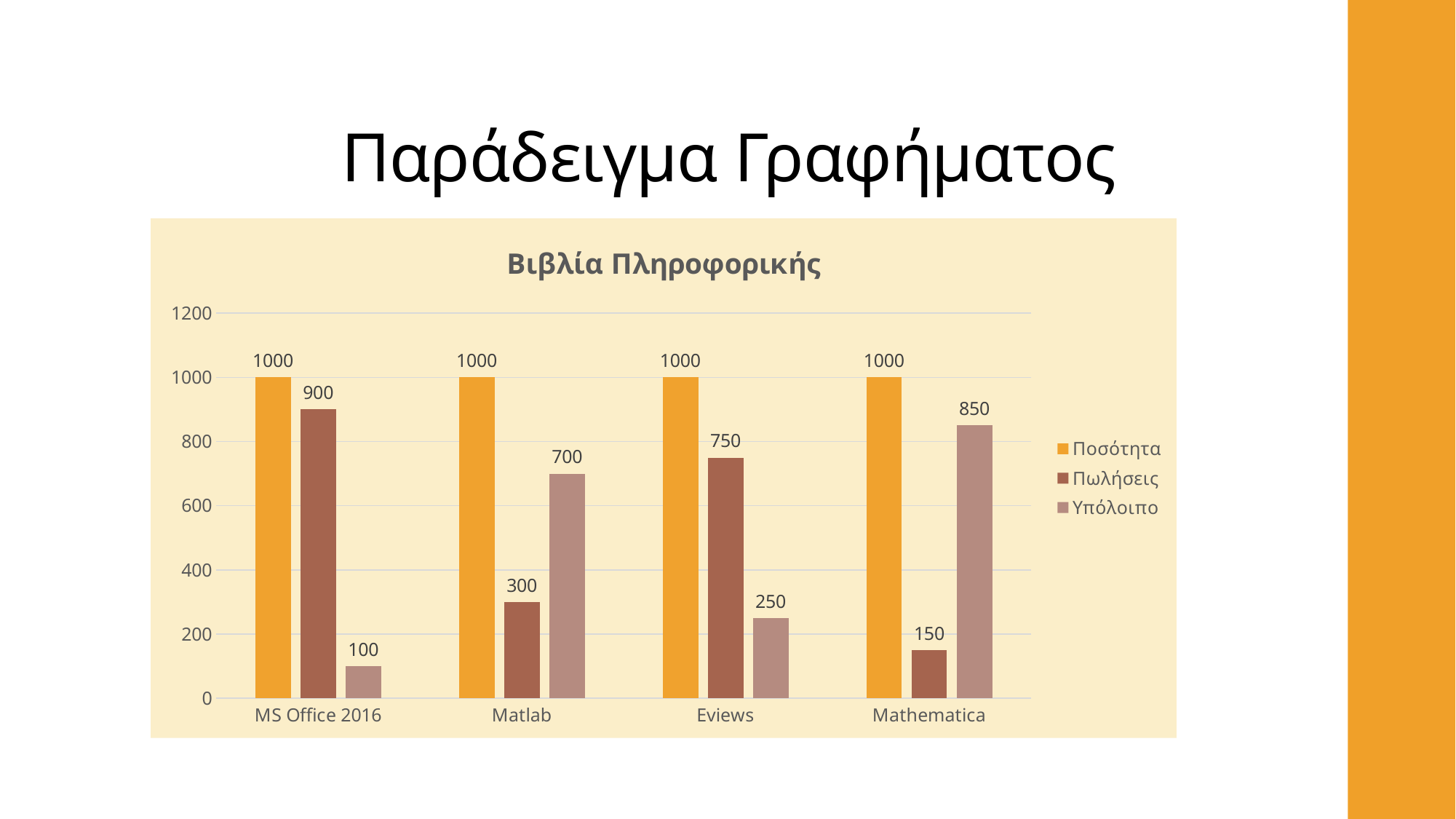
What is the Πωλήσεις value for MS Office 2016? 900 What is the difference between the Υπόλοιπο values for Mathematica and Eviews? 600 How many series does the legend list? 3 What is the Ποσότητα value for Mathematica? 1000 How many categories are shown on the x axis? 4 What kind of chart is shown? Bar chart Which is larger: the Πωλήσεις value for Matlab or the Πωλήσεις value for Mathematica? Matlab What is the title of the chart? Βιβλία Πληροφορικής Which category has the highest Πωλήσεις value? MS Office 2016 What is the Πωλήσεις value for Eviews? 750 What is the Υπόλοιπο value for Matlab? 700 Which category has the lowest Υπόλοιπο value? MS Office 2016